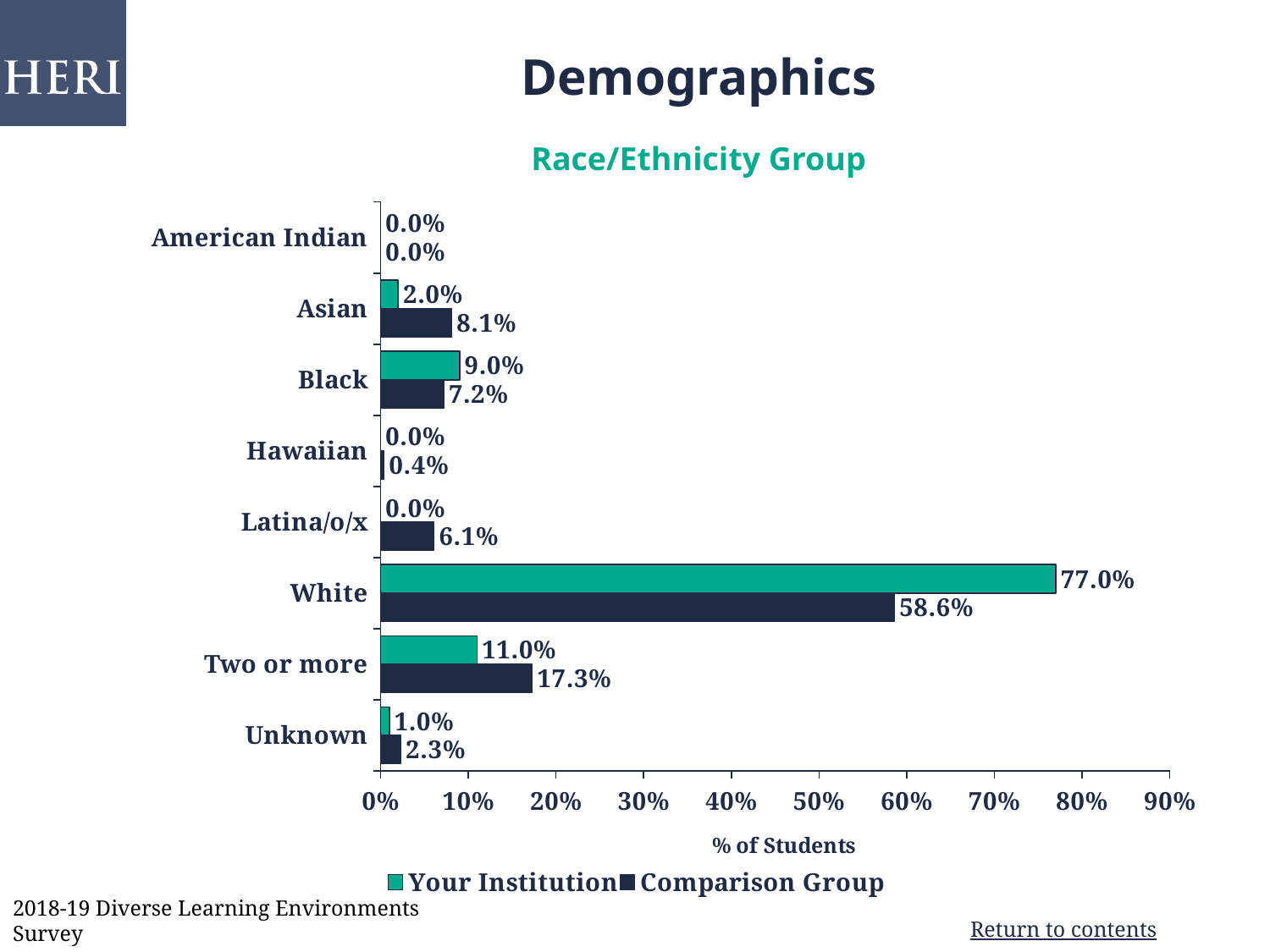
Which race/ethnicity group has the lowest value for the Comparison Group? American Indian What kind of chart is shown on the slide? Bar chart What is the difference between the Your Institution and Comparison Group values for White? 18.4% Is the Comparison Group value for White greater or less than 50%? greater Which race/ethnicity group has the highest value for Your Institution? White What is the value for Asian in the Comparison Group series? 8.1% How many series does the legend list? 2 How many race/ethnicity groups are shown on the chart? 8 What is the label of the x axis? % of Students What is the value for Two or more in the Comparison Group series? 17.3% Which is larger for Black: the Your Institution value or the Comparison Group value? Your Institution What is the value for White in the Your Institution series? 77.0%